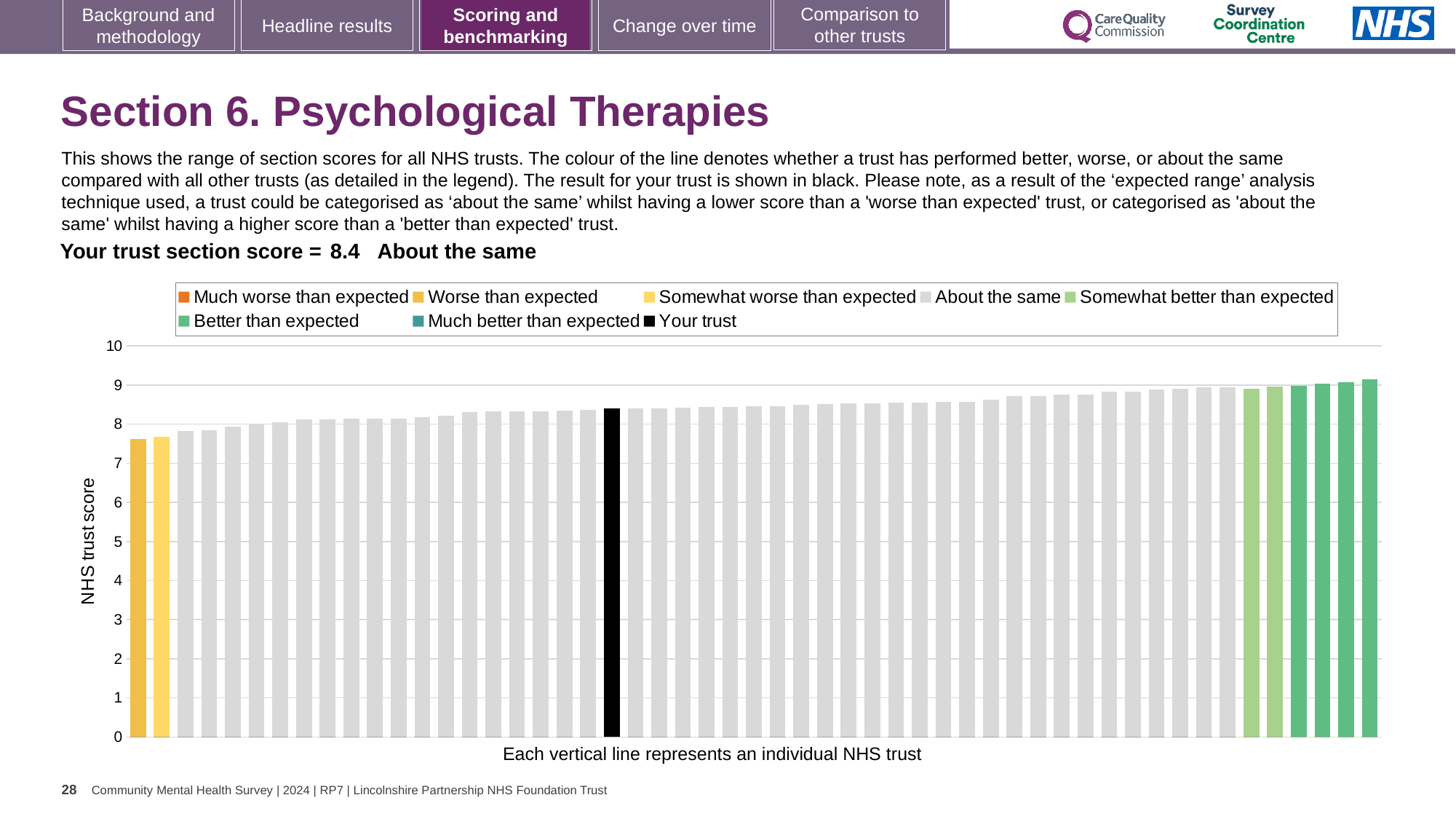
What kind of chart is shown on the slide? bar chart What is the label on the y axis of the chart? NHS trust score How many entries does the chart legend list? 8 Is the value of the tallest bar greater or less than 9? greater How many bars are coloured as 'Better than expected'? 4 Is the value of the black 'Your trust' bar greater or less than 8? greater How many bars are coloured as 'Somewhat better than expected'? 3 What is the section score for your trust shown on the slide? 8.4 Do the bar values rise or fall from left to right along the x axis? rise How many bars are coloured as 'Worse than expected'? 1 What colour is the bar representing your trust? black Is the value of the lowest bar greater or less than 8? less